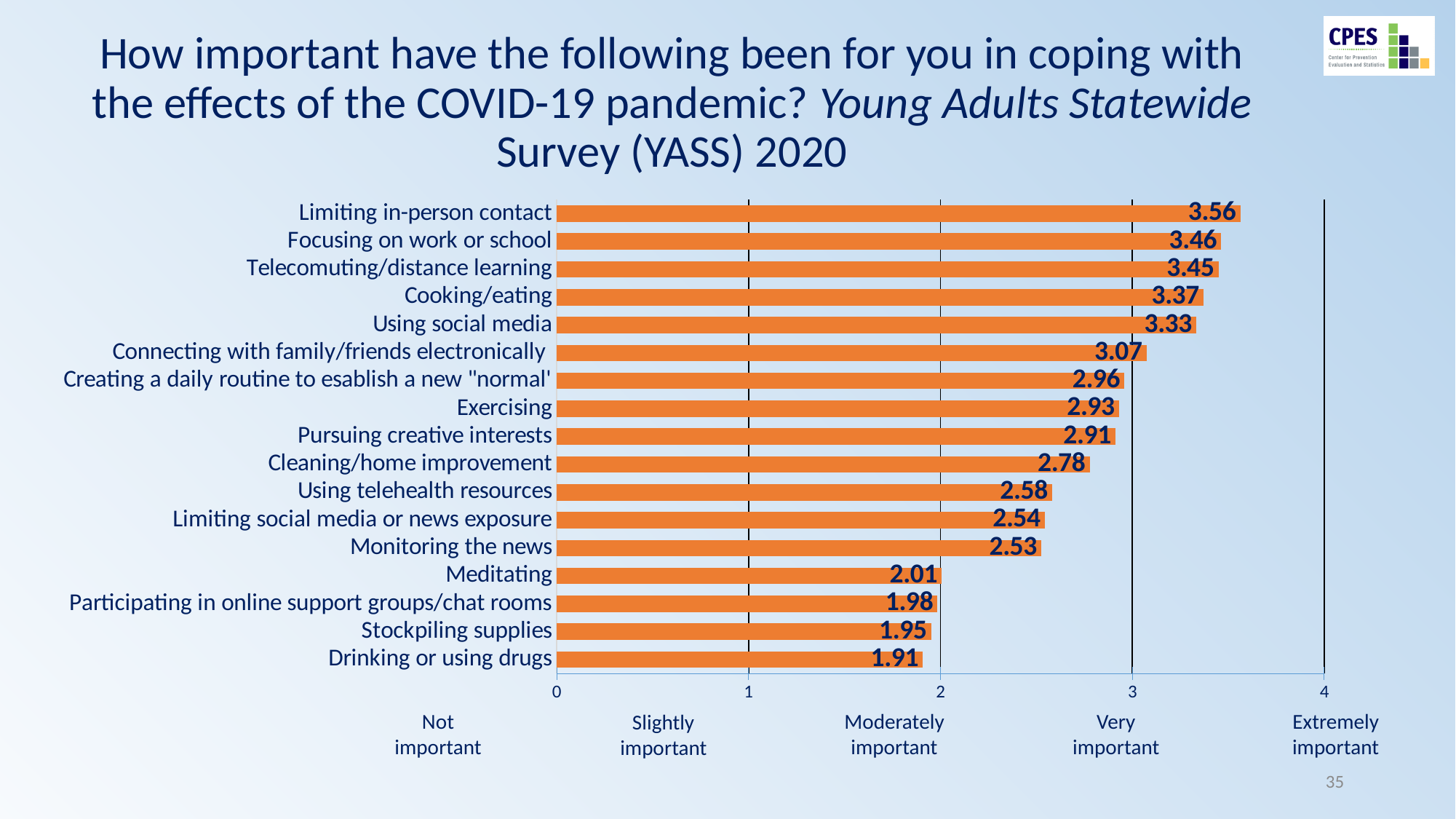
What is the value for Limiting in-person contact? 3.56 What label appears under the axis value 4? Extremely important Which category has the highest value? Limiting in-person contact What is the value for Meditating? 2.01 Is the value for Monitoring the news greater or less than 3? less What kind of chart is shown on the slide? bar chart Which category has the lowest value? Drinking or using drugs What is the value for Using telehealth resources? 2.58 What is the difference between the values for Cooking/eating and Exercising? 0.44 What is the difference between the values for Limiting in-person contact and Drinking or using drugs? 1.65 How many categories are shown in the chart? 17 Which is larger, the value for Using social media or the value for Cleaning/home improvement? Using social media